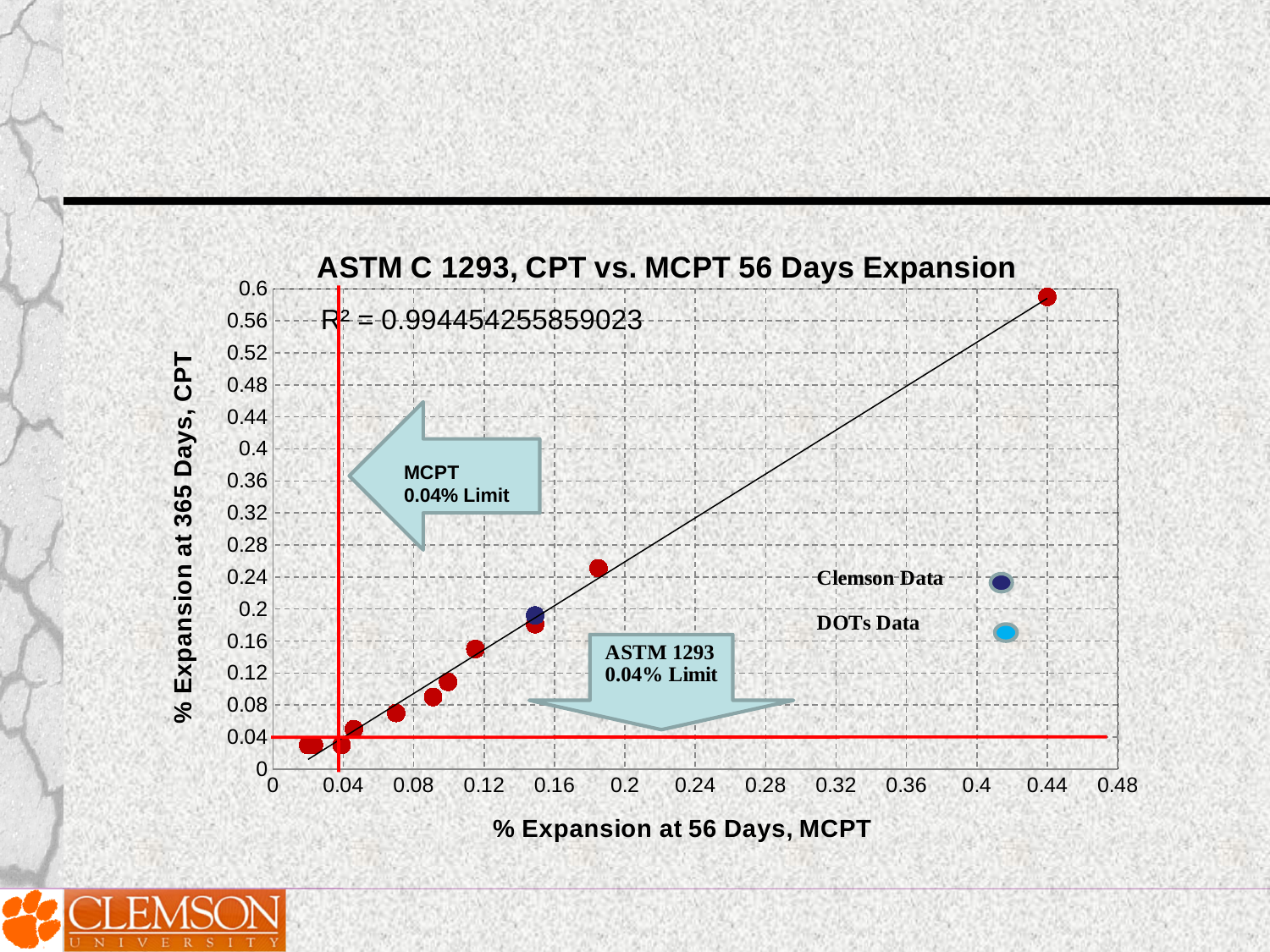
What R² value is printed on the chart? R² = 0.994454255859023 Which has the larger y-axis value: the data point near x = 0.44 or the data point near x = 0.18? the data point near x = 0.44 What kind of chart is shown on the slide? scatter chart What is the title of the chart? ASTM C 1293, CPT vs. MCPT 56 Days Expansion At what expansion value are the red MCPT and ASTM 1293 limit lines drawn? 0.04% Is the y-axis value of the highest plotted data point greater or less than 0.52? greater How many data series does the chart's legend list? 2 Is the y-axis value of the data point plotted near x = 0.18 greater or less than 0.2? greater Do the plotted values rise or fall as the x-axis value (% Expansion at 56 Days, MCPT) increases? rise Is the x-axis value of the highest plotted data point greater or less than 0.4? greater